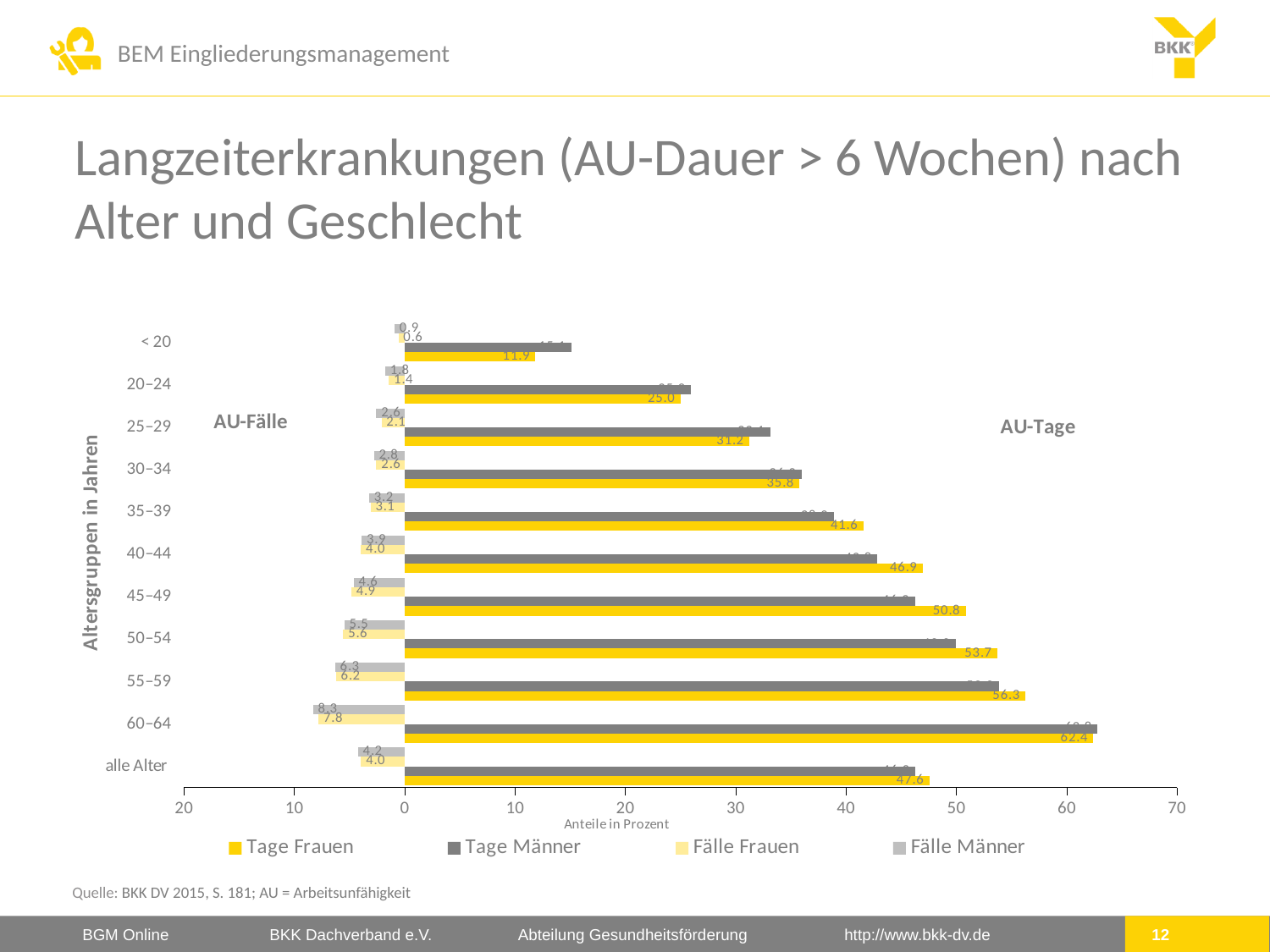
What kind of chart is shown on the slide? bar chart What is the value of Tage Frauen for the 60–64 age group? 62.4 Is the Tage Frauen value for 50–54 greater or less than 50? greater What is the difference between the Tage Frauen values for 60–64 and 55–59? 6.1 What is the value of Fälle Frauen for the 45–49 age group? 4.9 Which age group has the lowest Fälle Frauen value? < 20 Do the Tage Frauen values rise or fall as the age groups go from < 20 to 60–64? rise Which age group has the highest Tage Frauen value? 60–64 How many age-group categories are plotted on the y axis? 11 How many series does the legend list? 4 What is the value of Tage Frauen for 'alle Alter'? 47.6 What is the value of Fälle Männer for the 60–64 age group? 8.3